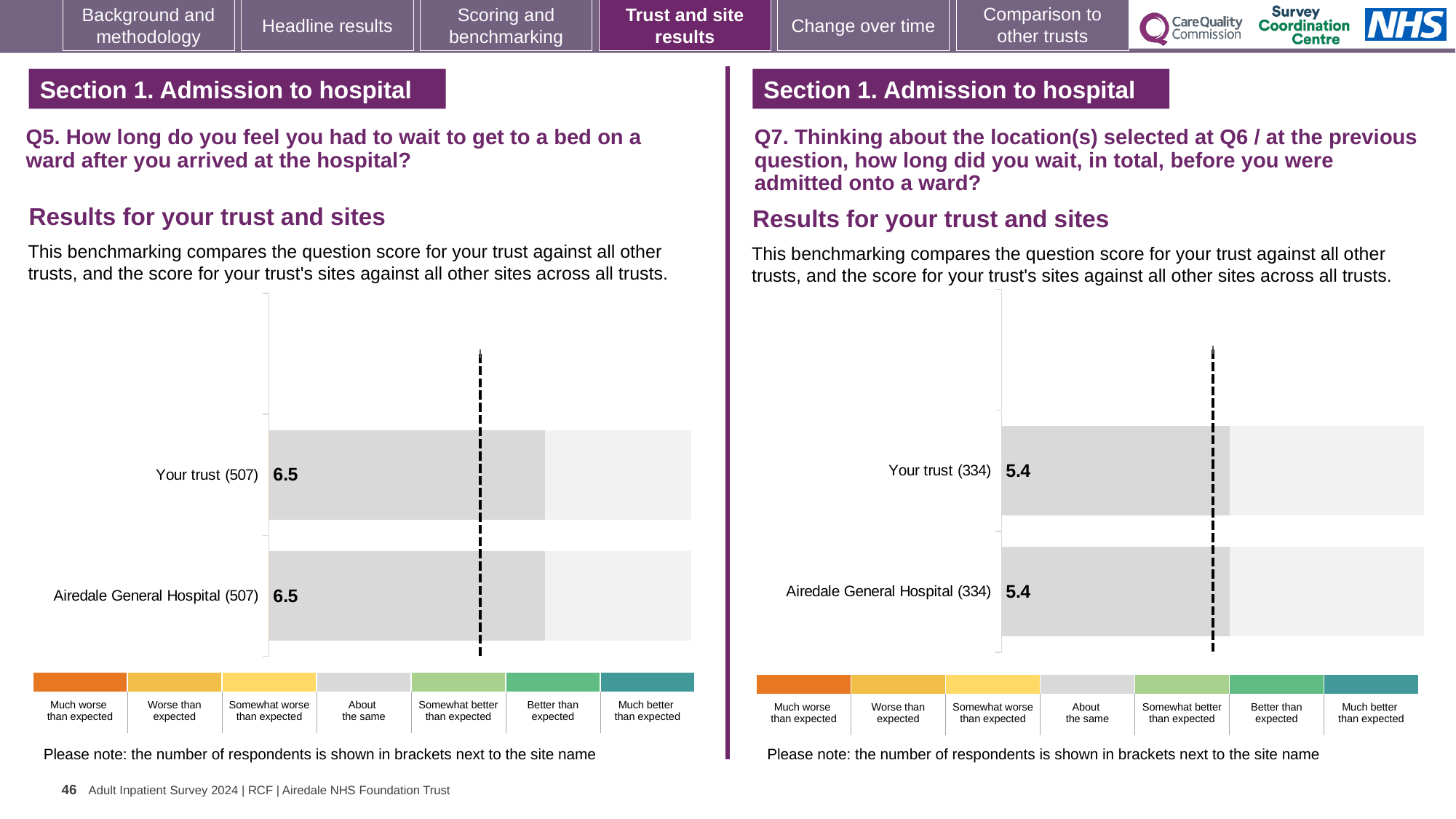
How many bars are plotted on the right chart (Q7)? 2 On the left chart (Q5), how many respondents are shown in brackets for Your trust? 507 On the right chart (Q7), what is the score for Your trust? 5.4 On the right chart (Q7), what is the score for Airedale General Hospital? 5.4 Is the score for Your trust on the left chart (Q5) larger or smaller than the score for Your trust on the right chart (Q7)? Larger On the left chart (Q5), what is the difference between the score for Your trust and the score for Airedale General Hospital? 0 How many bars are plotted on the left chart (Q5)? 2 On the left chart (Q5), what is the score for Your trust? 6.5 On the right chart (Q7), what is the difference between the score for Your trust and the score for Airedale General Hospital? 0 On the left chart (Q5), what is the score for Airedale General Hospital? 6.5 What kind of chart is the left chart (Q5)? Bar chart On the right chart (Q7), how many respondents are shown in brackets for Airedale General Hospital? 334